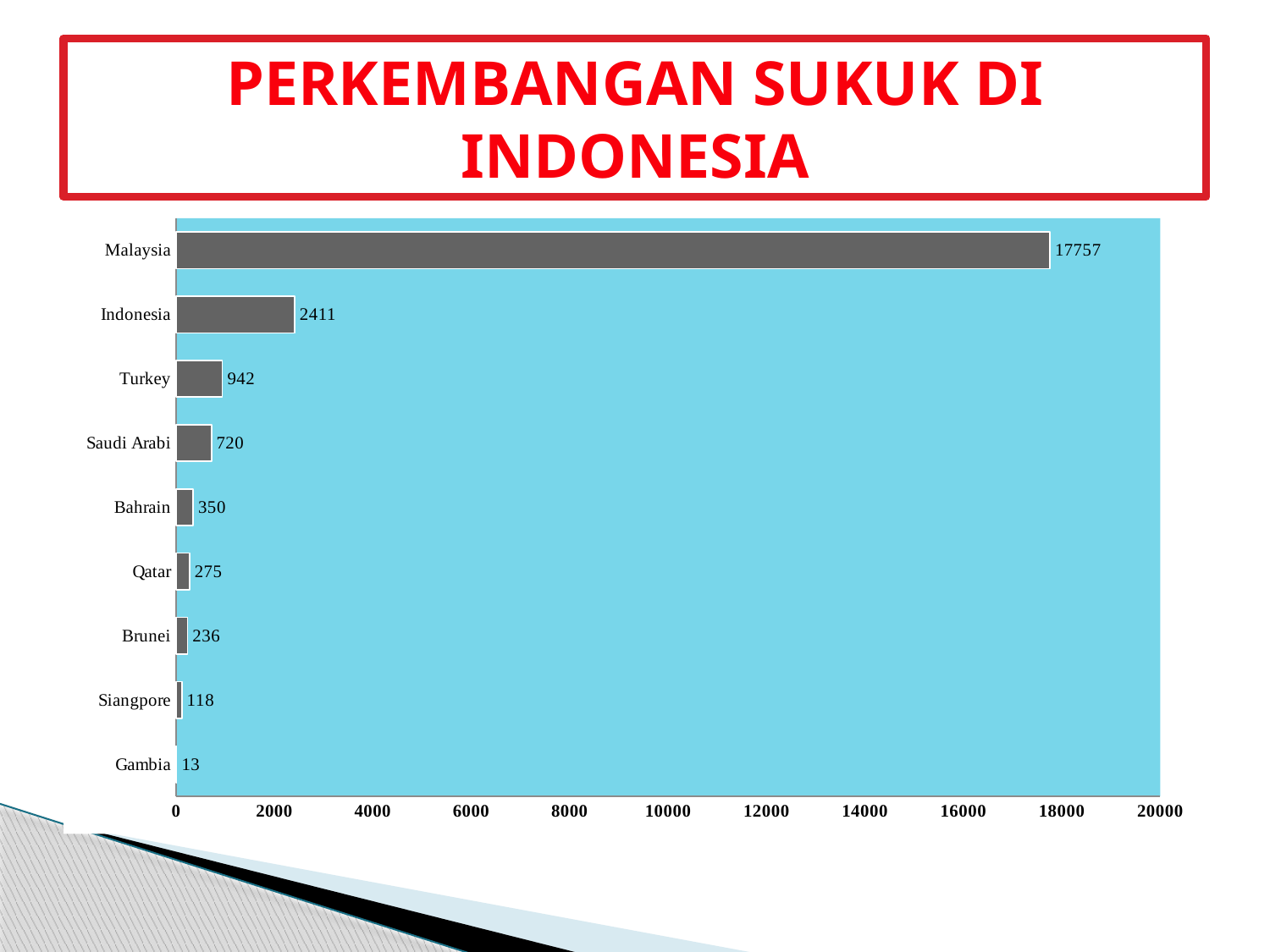
Which has a larger value, Bahrain or Qatar? Bahrain Which country has the lowest value? Gambia Is the value for Indonesia greater or less than 2000? greater What kind of chart is shown on the slide? Bar chart How many countries are shown in the chart? 9 What is the difference between the values for Malaysia and Indonesia? 15346 What is the value for Gambia? 13 What is the value for Malaysia? 17757 What is the difference between the values for Turkey and Saudi Arabi? 222 What is the value for Indonesia? 2411 Which country has the highest value? Malaysia What is the value for Saudi Arabi? 720